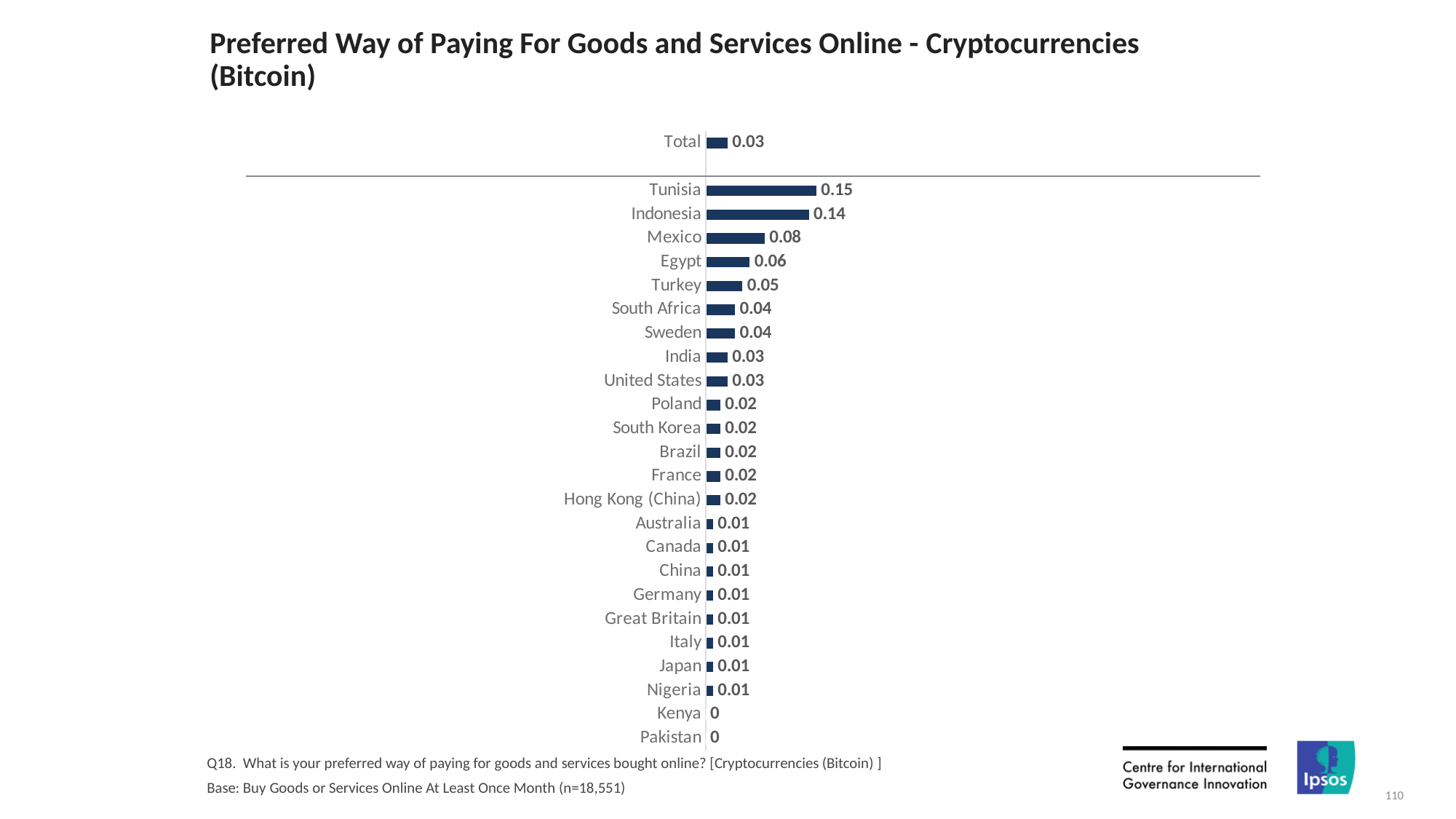
Which is larger, the value for Indonesia or the value for Mexico? Indonesia Which is larger, the value for Turkey or the value for India? Turkey What kind of chart is shown on the slide? Bar chart What is the value for Mexico? 0.08 How many country bars are shown below the Total bar? 24 What is the value for Tunisia? 0.15 What is the value for Sweden? 0.04 What is the value for Total? 0.03 What is the value for Kenya? 0 What is the difference between the values for Tunisia and Indonesia? 0.01 Which country has the highest value? Tunisia What is the difference between the values for Mexico and Egypt? 0.02